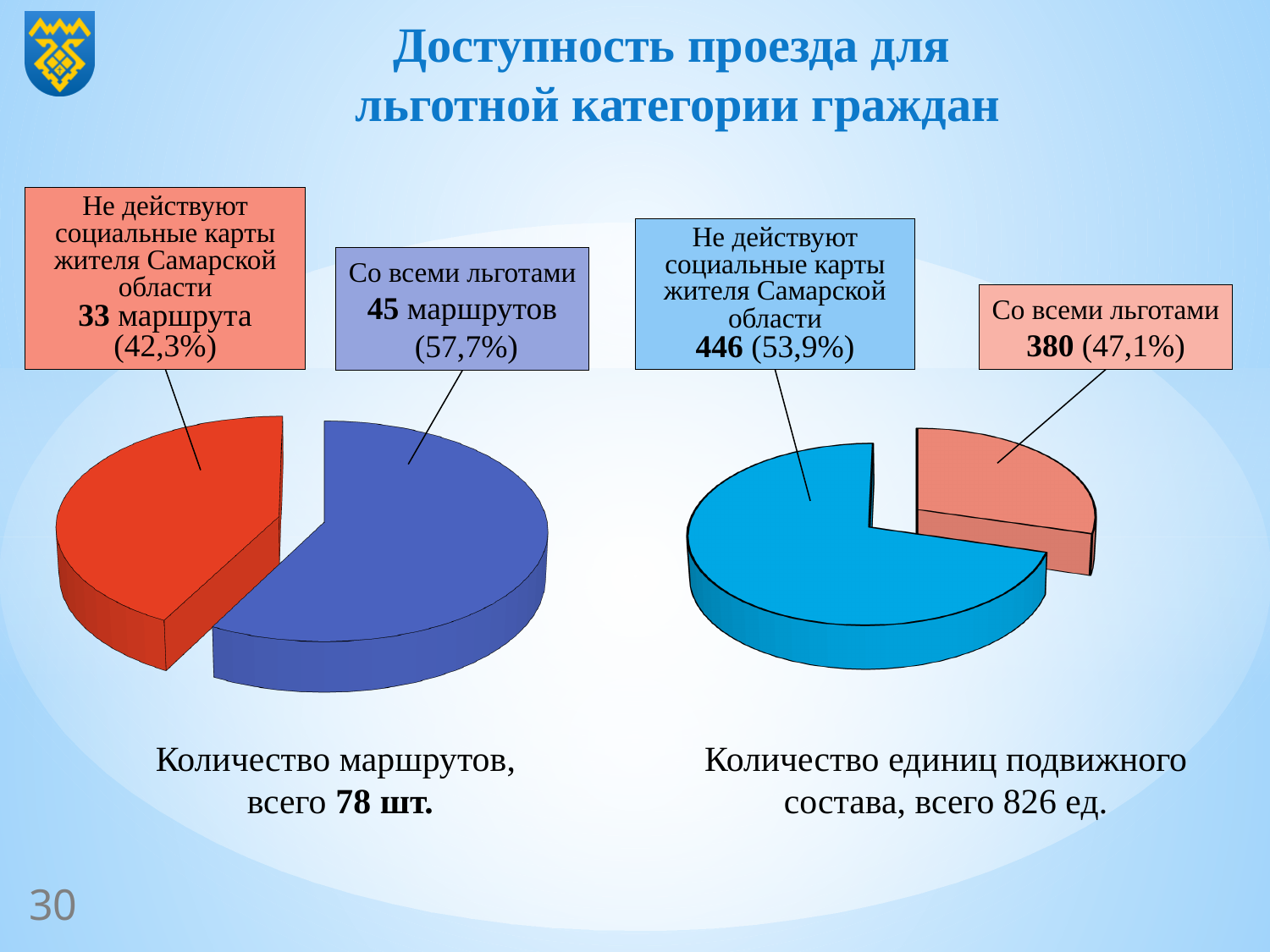
In the right pie chart (Количество единиц подвижного состава), how many units are in the 'Не действуют социальные карты жителя Самарской области' slice? 446 What kind of chart is used on the left of the slide (Количество маршрутов)? pie chart In the left pie chart (Количество маршрутов), what is the difference between the number of routes 'Со всеми льготами' and the number where social cards do not work? 12 In the right pie chart (Количество единиц подвижного состава), what share of the pie is the 'Со всеми льготами' slice? 47,1% In the right pie chart (Количество единиц подвижного состава), what is the difference between the 446 and 380 slices? 66 In the left pie chart (Количество маршрутов), how many routes are in the 'Со всеми льготами' slice? 45 In the left pie chart (Количество маршрутов), which slice is larger: 'Со всеми льготами' or 'Не действуют социальные карты жителя Самарской области'? Со всеми льготами How many slices does the right pie chart (Количество единиц подвижного состава) have? 2 In the left pie chart (Количество маршрутов), what share of the pie is the 'Не действуют социальные карты жителя Самарской области' slice? 42,3% What is the total number of routes shown for the left pie chart (Количество маршрутов)? 78 шт. What colour is the 'Со всеми льготами' slice in the left pie chart (Количество маршрутов)? blue In the right pie chart (Количество единиц подвижного состава), which slice is the largest? Не действуют социальные карты жителя Самарской области